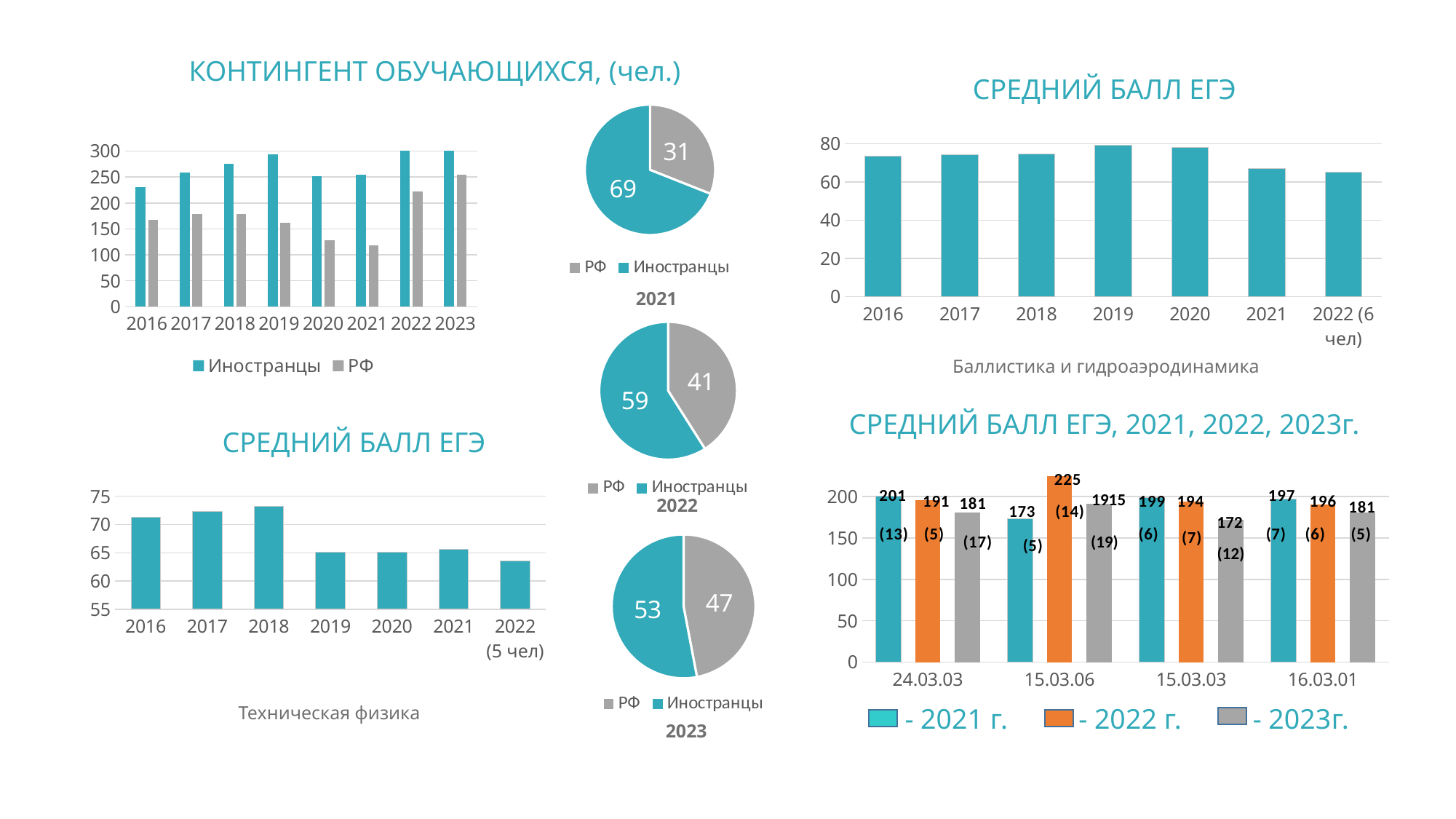
In the chart 'СРЕДНИЙ БАЛЛ ЕГЭ' for Техническая физика (bottom left), which year has the highest value? 2018 In the chart 'СРЕДНИЙ БАЛЛ ЕГЭ, 2021, 2022, 2023г.', what is the 2022 value for 15.03.06? 225 In the chart 'СРЕДНИЙ БАЛЛ ЕГЭ, 2021, 2022, 2023г.', what is the 2023 value for 15.03.03? 172 How many series does the legend of the chart 'СРЕДНИЙ БАЛЛ ЕГЭ, 2021, 2022, 2023г.' list? 3 In the chart 'СРЕДНИЙ БАЛЛ ЕГЭ, 2021, 2022, 2023г.', what is the difference between the 2021 and 2023 values for 24.03.03? 20 In the chart 'СРЕДНИЙ БАЛЛ ЕГЭ, 2021, 2022, 2023г.', which is larger for 16.03.01: the 2022 value or the 2023 value? 2022 In the 2022 pie chart, what is the difference between the Иностранцы and РФ values? 18 How many years are shown on the x axis of the chart 'КОНТИНГЕНТ ОБУЧАЮЩИХСЯ, (чел.)'? 8 In the 2021 pie chart, what is the value shown for Иностранцы? 69 In the chart 'КОНТИНГЕНТ ОБУЧАЮЩИХСЯ, (чел.)', is the value for РФ in 2021 greater or less than 150? less In the chart 'СРЕДНИЙ БАЛЛ ЕГЭ, 2021, 2022, 2023г.', which category has the highest 2021 value? 24.03.03 In the 2023 pie chart, what is the value shown for РФ? 47